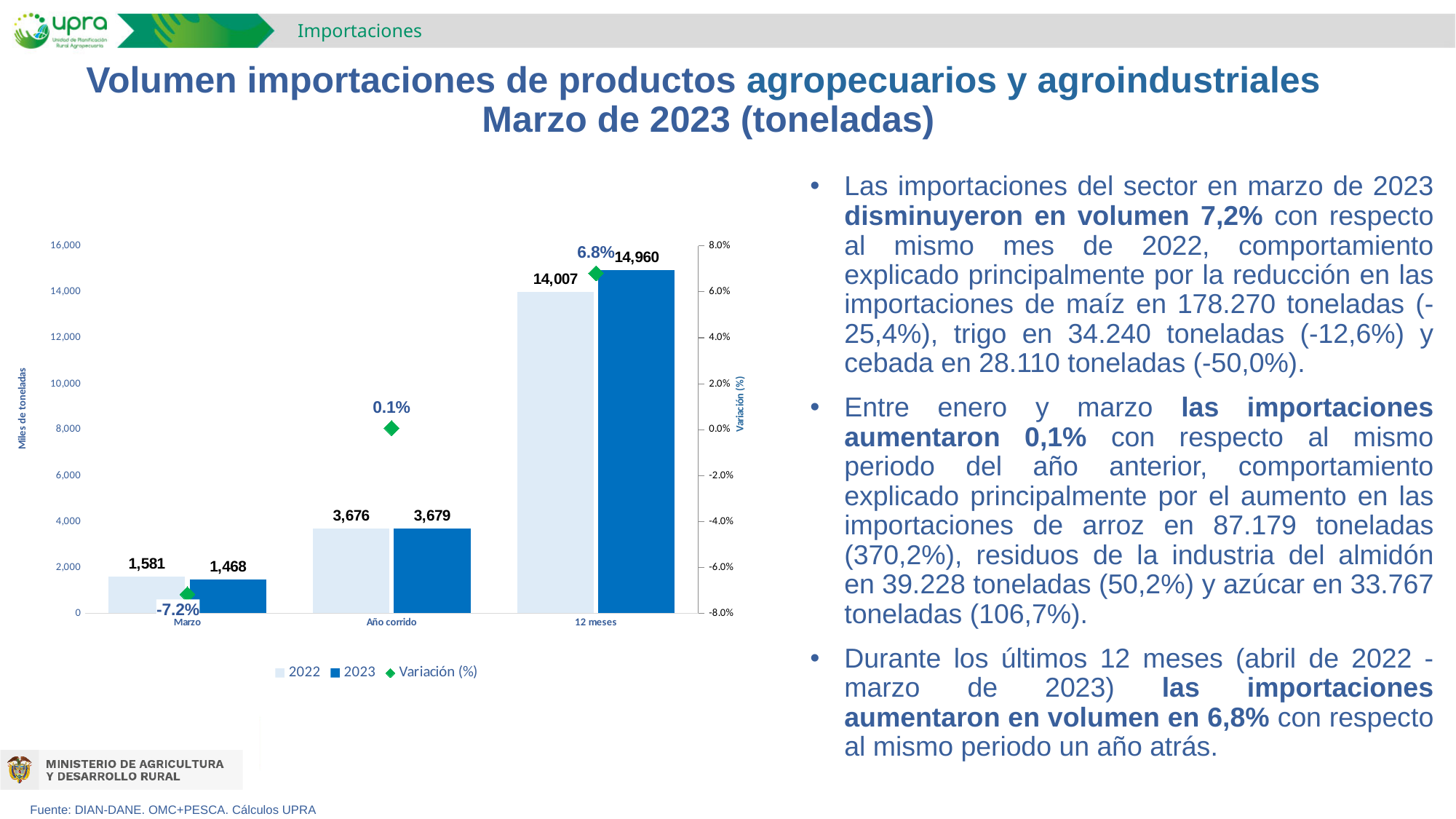
How many categories are shown on the x axis? 3 Which category has the highest 2023 value? 12 meses What is the Variación (%) value for Marzo? -7.2% What kind of chart is used for the 2022 and 2023 series? bar chart What is the 2023 value for 12 meses? 14,960 What is the difference between the 2023 and 2022 values for 12 meses? 953 Which category has the lowest 2022 value? Marzo How many series does the legend list? 3 What is the label of the left vertical axis? Miles de toneladas What is the 2022 value for Marzo? 1,581 Which is larger for Marzo, the 2022 value or the 2023 value? 2022 What is the Variación (%) value for Año corrido? 0.1%